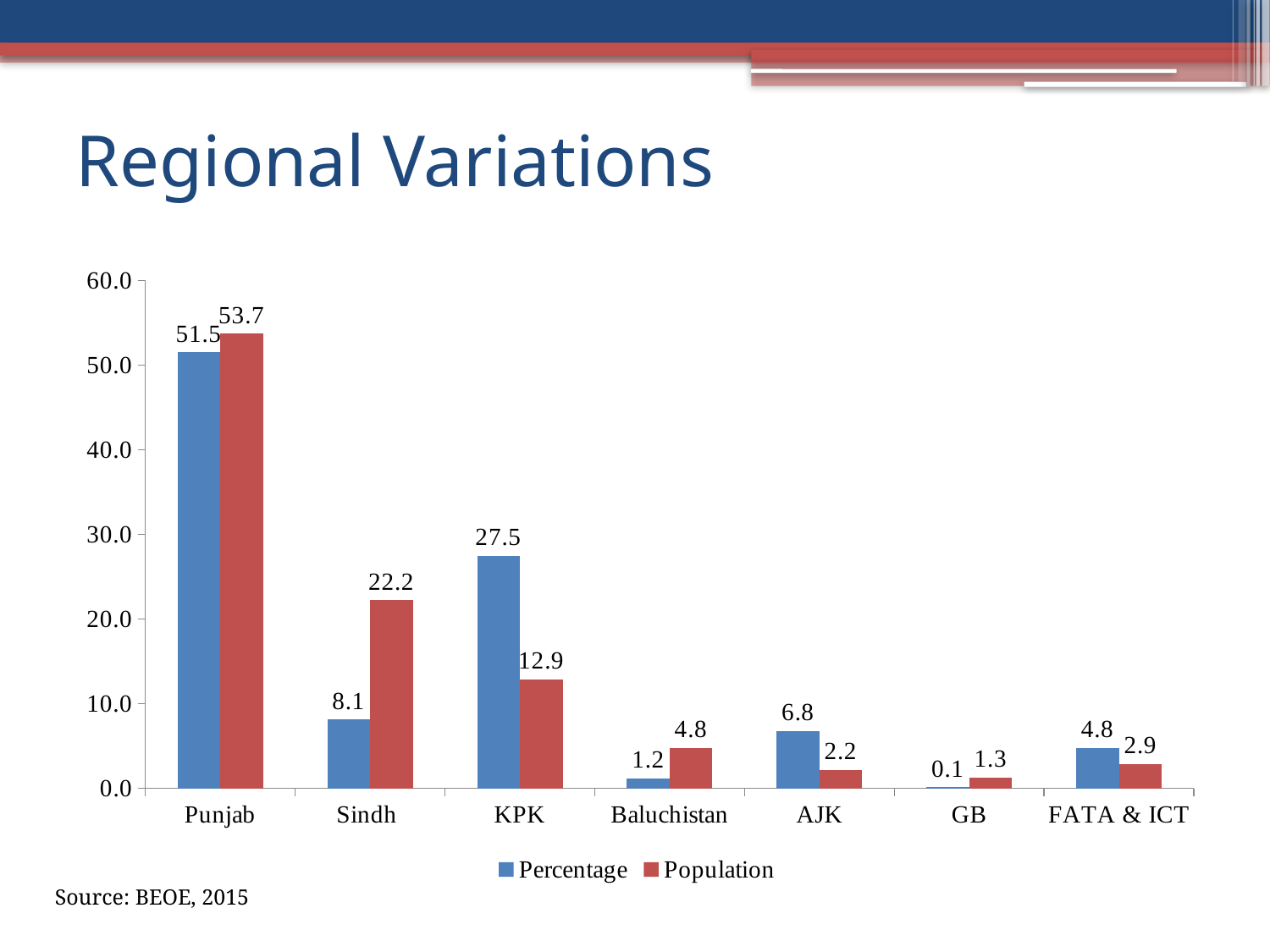
What is the Population value for Baluchistan? 4.8 How many series does the legend list? 2 What is the title of the slide? Regional Variations What is the Population value for Sindh? 22.2 Which is larger for KPK, the Percentage value or the Population value? Percentage What source is cited below the chart? BEOE, 2015 What is the difference between the Population and Percentage values for Sindh? 14.1 How many regions are shown on the x axis? 7 Which region has the highest Percentage value? Punjab Which region has the lowest Percentage value? GB What is the Percentage value for KPK? 27.5 What kind of chart is shown on the slide? Bar chart